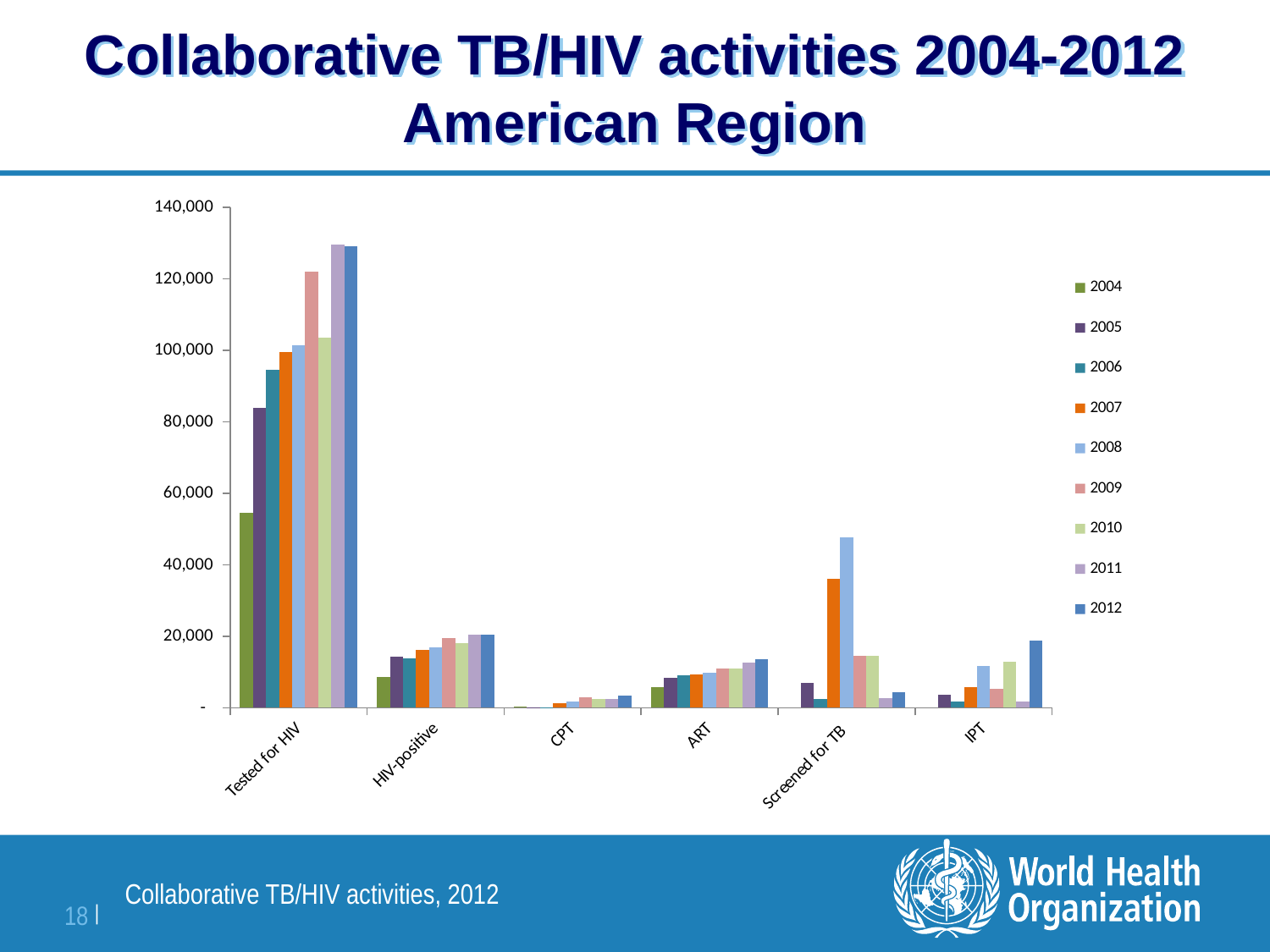
Is the 2011 value for Tested for HIV greater or less than 120,000? greater Within the Screened for TB category, which year has the highest bar? 2008 How many categories are shown on the x axis of the chart? 6 What kind of chart is shown on the slide? Bar chart Is the 2008 value for Screened for TB greater or less than 40,000? greater Which category has the tallest bars in the chart? Tested for HIV How many series does the chart's legend list? 9 Which year is listed first in the chart's legend? 2004 Which category has the lowest bars in the chart? CPT For Tested for HIV, which is larger: the 2004 value or the 2005 value? 2005 Is the 2007 value for Screened for TB greater or less than 40,000? less